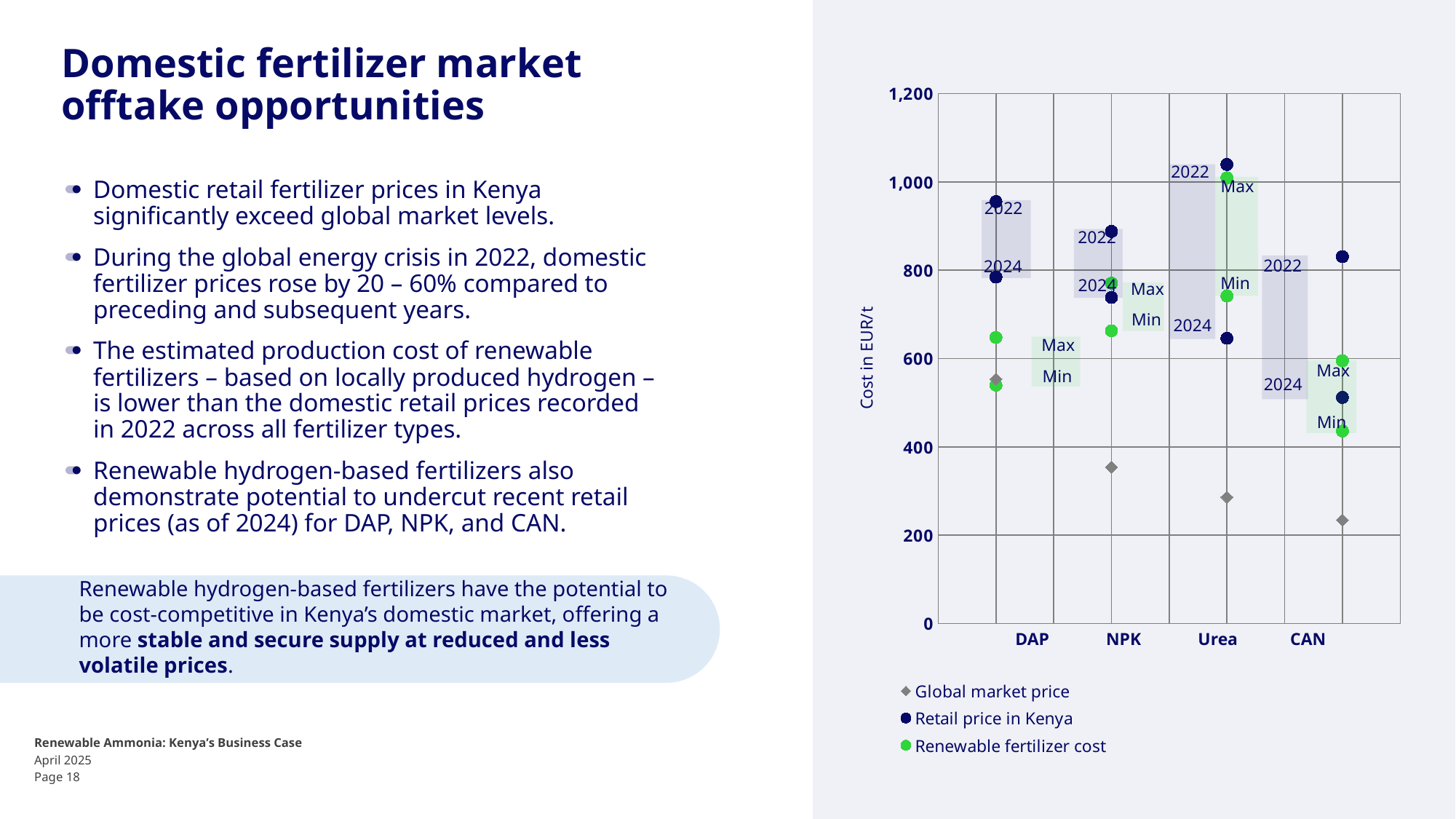
Is the 2022 retail price in Kenya for DAP greater or less than 800 EUR/t? greater What is the title of the chart's vertical axis? Cost in EUR/t Is the 2022 retail price in Kenya for Urea greater or less than 1,000 EUR/t? greater How many fertilizer types are shown on the x axis of the chart? 4 Is the global market price for NPK greater or less than 400 EUR/t? less Which fertilizer type has the lowest global market price? CAN What kind of chart is shown on the slide? Scatter (dot) chart Which fertilizer type has the highest global market price? DAP How many series does the chart legend list? 3 Which fertilizer type has the highest 2022 retail price in Kenya? Urea Which is larger: the 2024 retail price in Kenya for DAP or for NPK? DAP